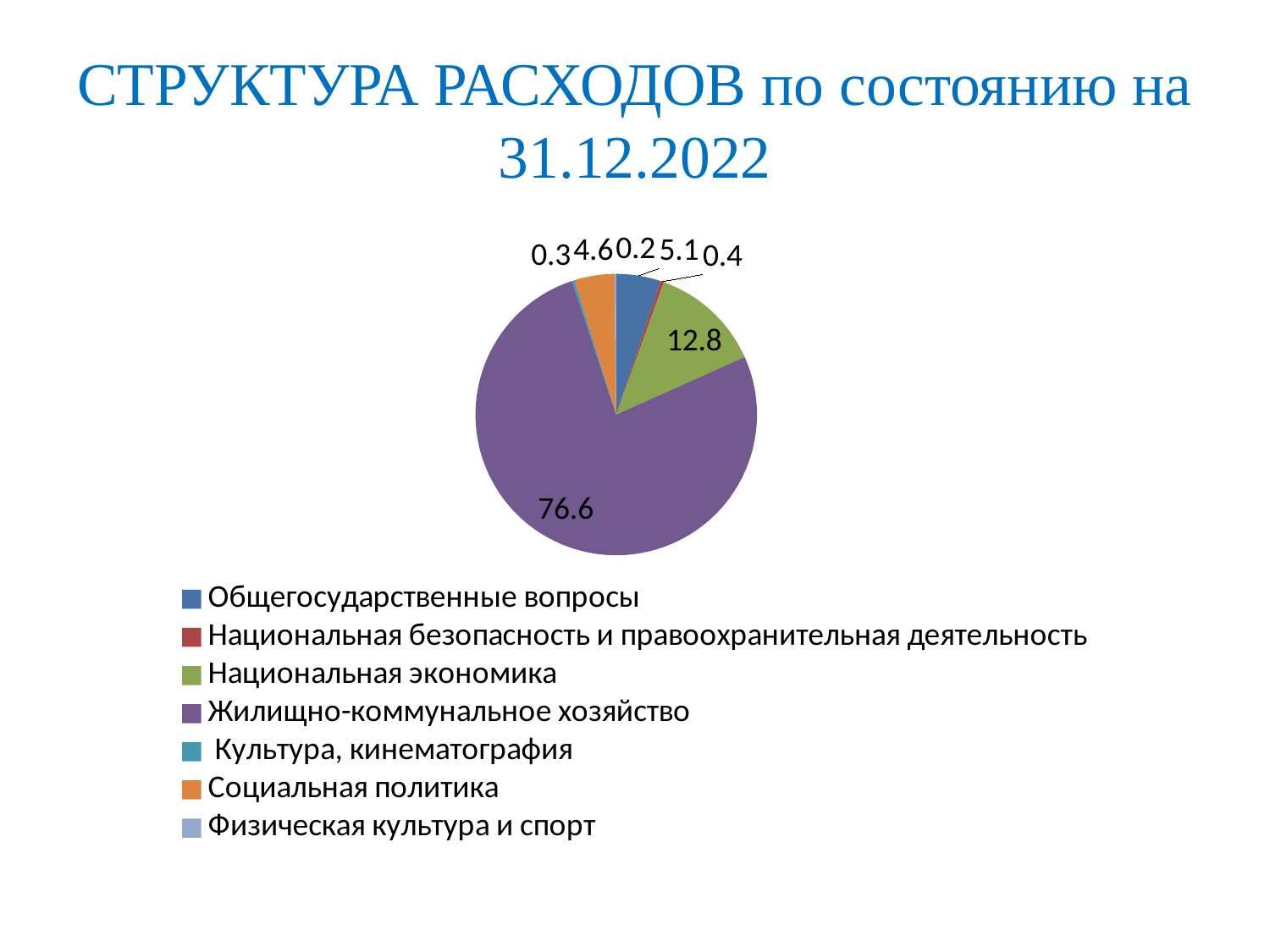
What is the difference between the values for Жилищно-коммунальное хозяйство and Национальная экономика? 63.8 What is the value shown for Общегосударственные вопросы? 5.1 What is the value shown for Жилищно-коммунальное хозяйство? 76.6 What colour is the slice for Жилищно-коммунальное хозяйство? purple What is the difference between the values for Общегосударственные вопросы and Социальная политика? 0.5 What is the value shown for Национальная экономика? 12.8 What kind of chart is shown on the slide? pie chart How many categories does the legend of the pie chart list? 7 Which is larger, the share for Национальная экономика or the share for Социальная политика? Национальная экономика Which category has the largest share of the pie chart? Жилищно-коммунальное хозяйство What is the value shown for Социальная политика? 4.6 What is the title of the slide containing the pie chart? СТРУКТУРА РАСХОДОВ по состоянию на 31.12.2022